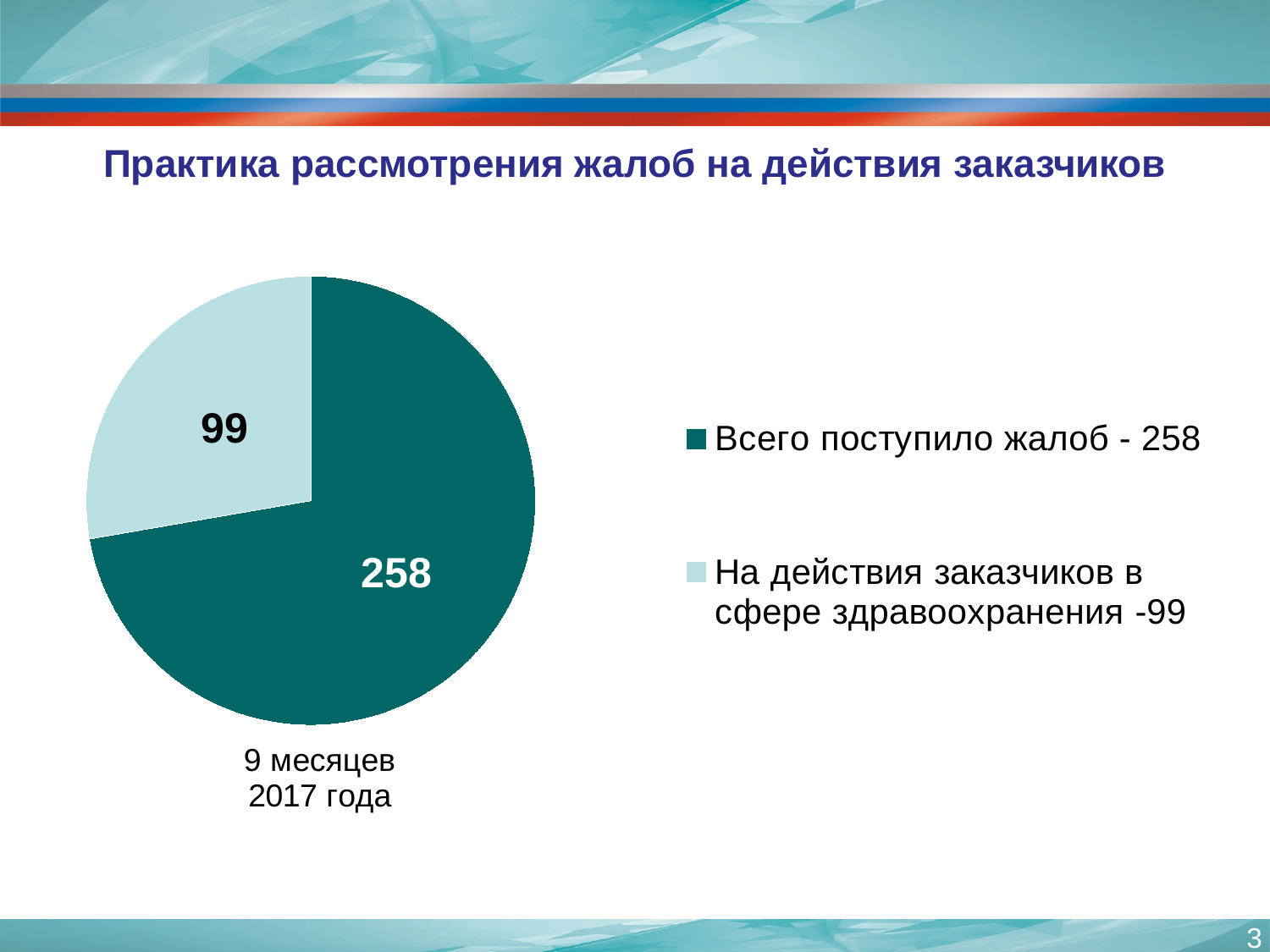
What kind of chart is shown on the slide? pie chart What is the difference between the values 258 and 99 shown on the pie chart? 159 Which slice of the pie chart is the largest? Всего поступило жалоб - 258 What value is shown for the slice "Всего поступило жалоб"? 258 How many slices does the pie chart have? 2 What value is shown for the slice "На действия заказчиков в сфере здравоохранения"? 99 What period is indicated in the caption below the pie chart? 9 месяцев 2017 года How many entries does the legend list? 2 What is the title of the slide containing the pie chart? Практика рассмотрения жалоб на действия заказчиков Which slice of the pie chart is the smallest? На действия заказчиков в сфере здравоохранения -99 Which is larger: the slice labelled 258 or the slice labelled 99? 258